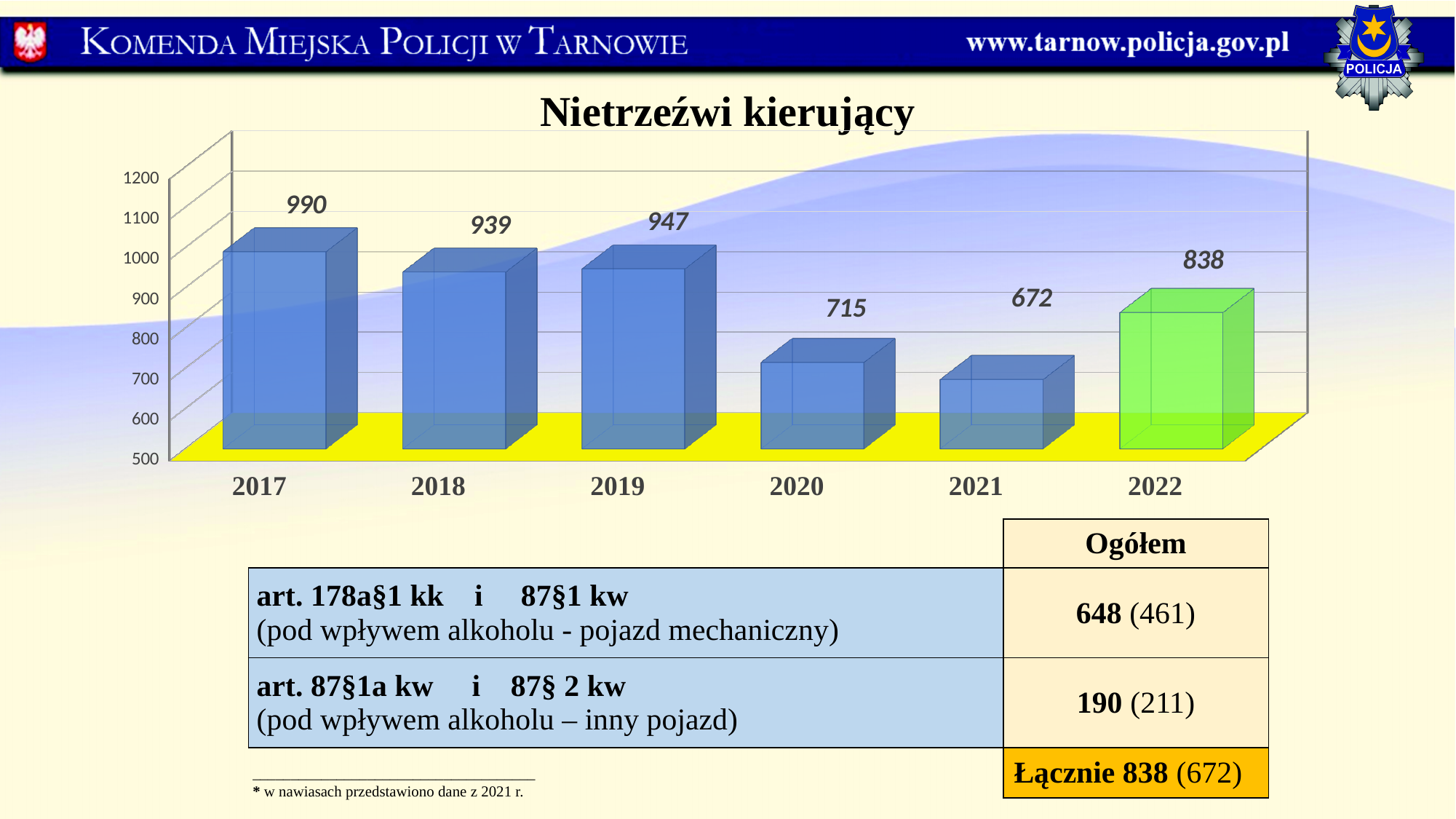
What is the value for 2020 in the chart? 715 What is the difference between the values for 2022 and 2021? 166 What is the value for 2017 in the chart? 990 Which year has the highest value in the chart? 2017 What is the difference between the values for 2017 and 2018? 51 What kind of chart is shown on the slide? bar chart Which is larger, the value for 2018 or the value for 2019? 2019 Is the value for 2020 greater or less than 800? less Which year has the lowest value in the chart? 2021 How many years are shown on the x axis of the chart? 6 What is the title of the chart? Nietrzeźwi kierujący What is the value for 2022 in the chart? 838